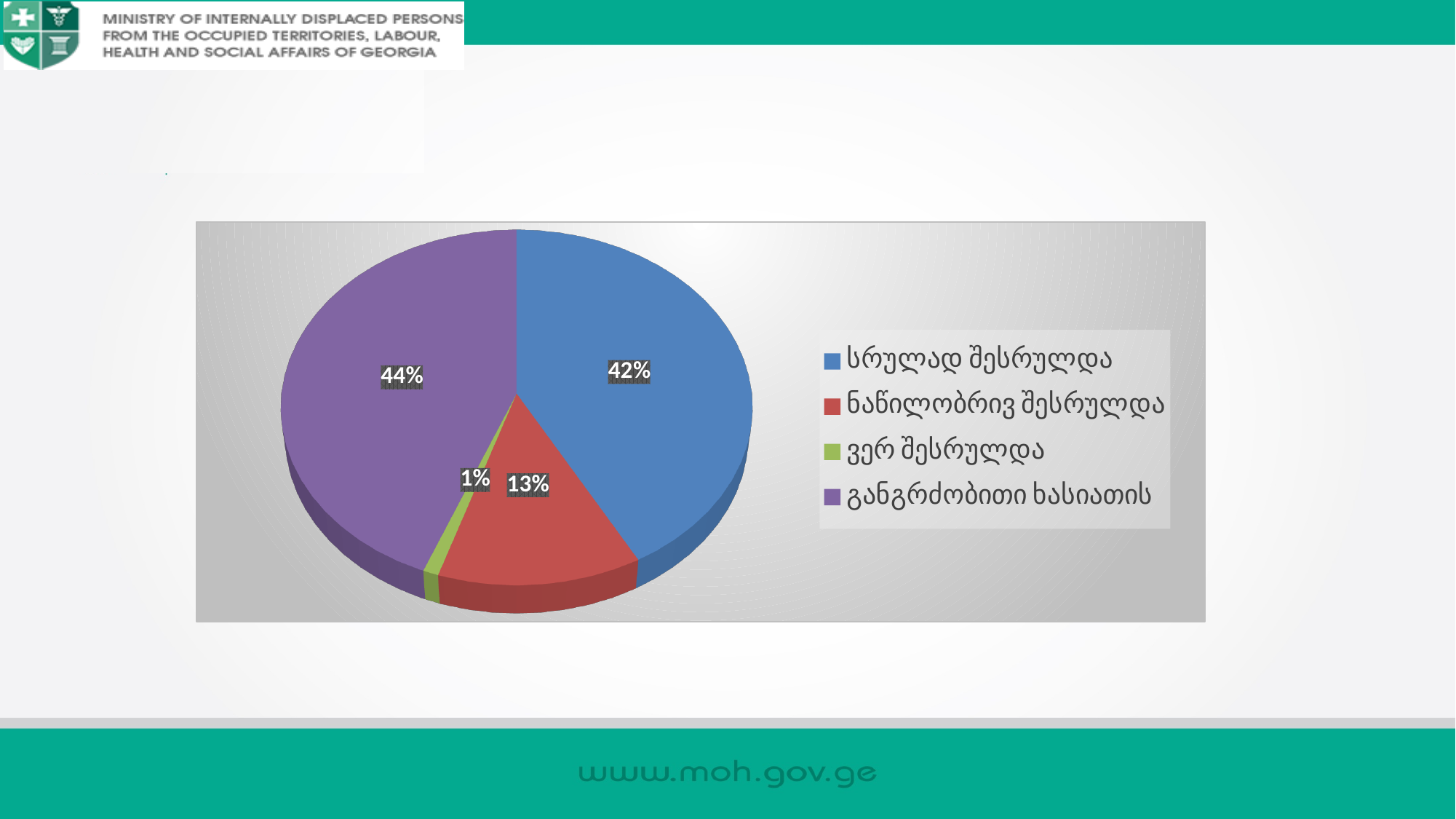
What is the difference in percentage points between the slices for სრულად შესრულდა and ნაწილობრივ შესრულდა? 29% What is the difference in percentage points between the slices for განგრძობითი ხასიათის and სრულად შესრულდა? 2% Which category has the smallest slice of the pie? ვერ შესრულდა What share of the pie does the slice for განგრძობითი ხასიათის represent? 44% What share of the pie does the slice for ნაწილობრივ შესრულდა represent? 13% Which is larger, the slice for ნაწილობრივ შესრულდა or the slice for ვერ შესრულდა? ნაწილობრივ შესრულდა What kind of chart is shown on the slide? pie chart What share of the pie does the slice for სრულად შესრულდა represent? 42% Which category has the largest slice of the pie? განგრძობითი ხასიათის How many categories does the pie chart show? 4 What colour is the slice for ვერ შესრულდა? green